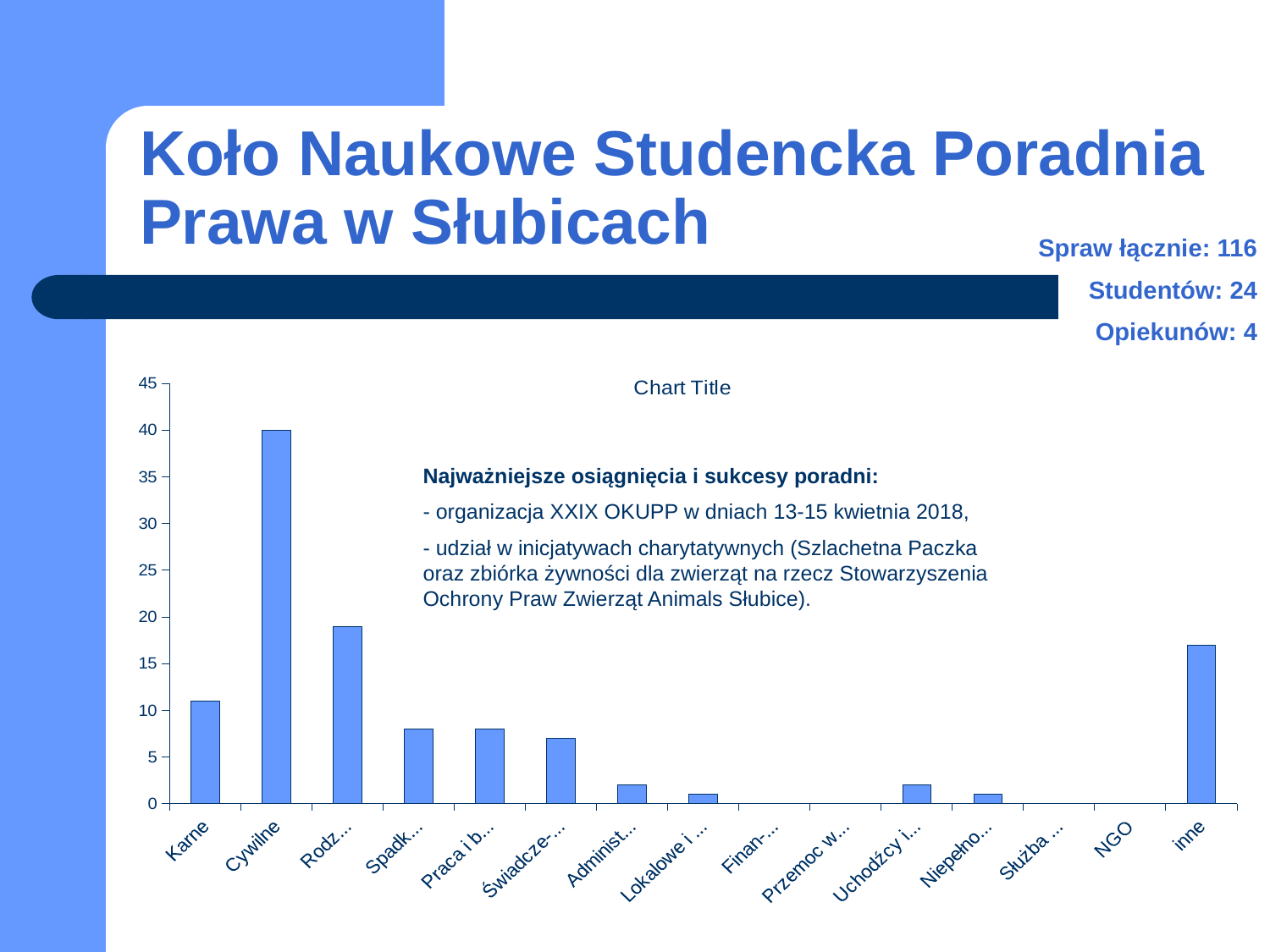
Which category has the highest value in the chart? Cywilne Is the value for Spadk... greater or less than 10? less What type of chart is shown on the slide? bar chart What is the title of the chart? Chart Title Which has a larger value, Karne or Rodz...? Rodz... Is the value for inne greater or less than 15? greater Which has a larger value, Karne or inne? inne How many categories are shown on the x axis of the chart? 15 What is the value for Cywilne? 40 Is the value for Administ... greater or less than 5? less